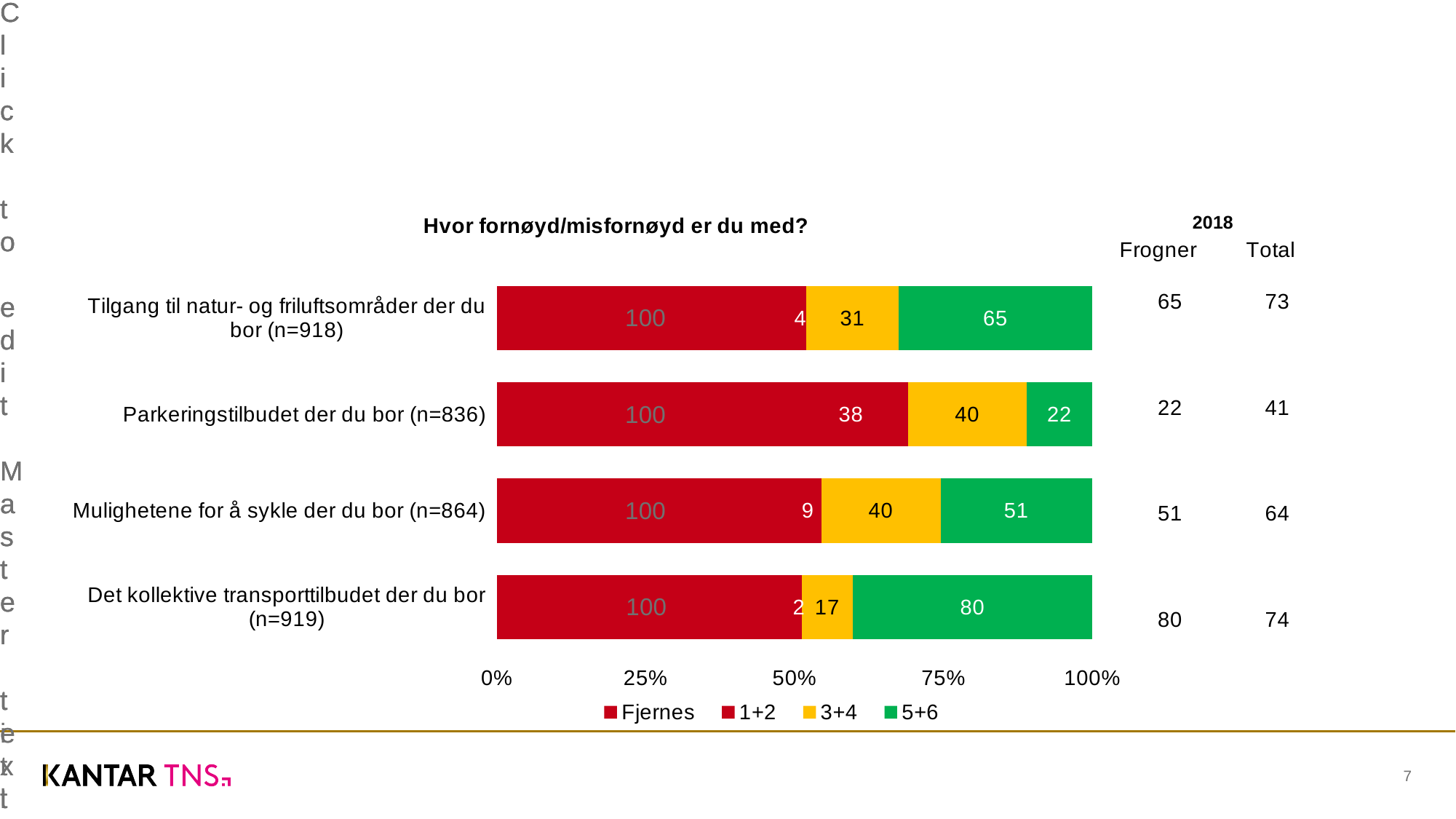
What kind of chart is shown on the slide? stacked bar chart What is the 5+6 value for 'Det kollektive transporttilbudet der du bor (n=919)'? 80 What is the difference between the 5+6 value for 'Tilgang til natur- og friluftsområder der du bor (n=918)' and the 5+6 value for 'Parkeringstilbudet der du bor (n=836)'? 43 How many categories are plotted on the chart? 4 What is the 3+4 value for 'Det kollektive transporttilbudet der du bor (n=919)'? 17 What is the title of the chart? Hvor fornøyd/misfornøyd er du med? Which category has the highest 5+6 value? Det kollektive transporttilbudet der du bor (n=919) What is the 3+4 value for 'Parkeringstilbudet der du bor (n=836)'? 40 What is the 1+2 value for 'Mulighetene for å sykle der du bor (n=864)'? 9 Which category has the lowest 5+6 value? Parkeringstilbudet der du bor (n=836) How many series does the legend list? 4 Which is larger: the 1+2 value for 'Parkeringstilbudet der du bor (n=836)' or the 1+2 value for 'Tilgang til natur- og friluftsområder der du bor (n=918)'? Parkeringstilbudet der du bor (n=836)